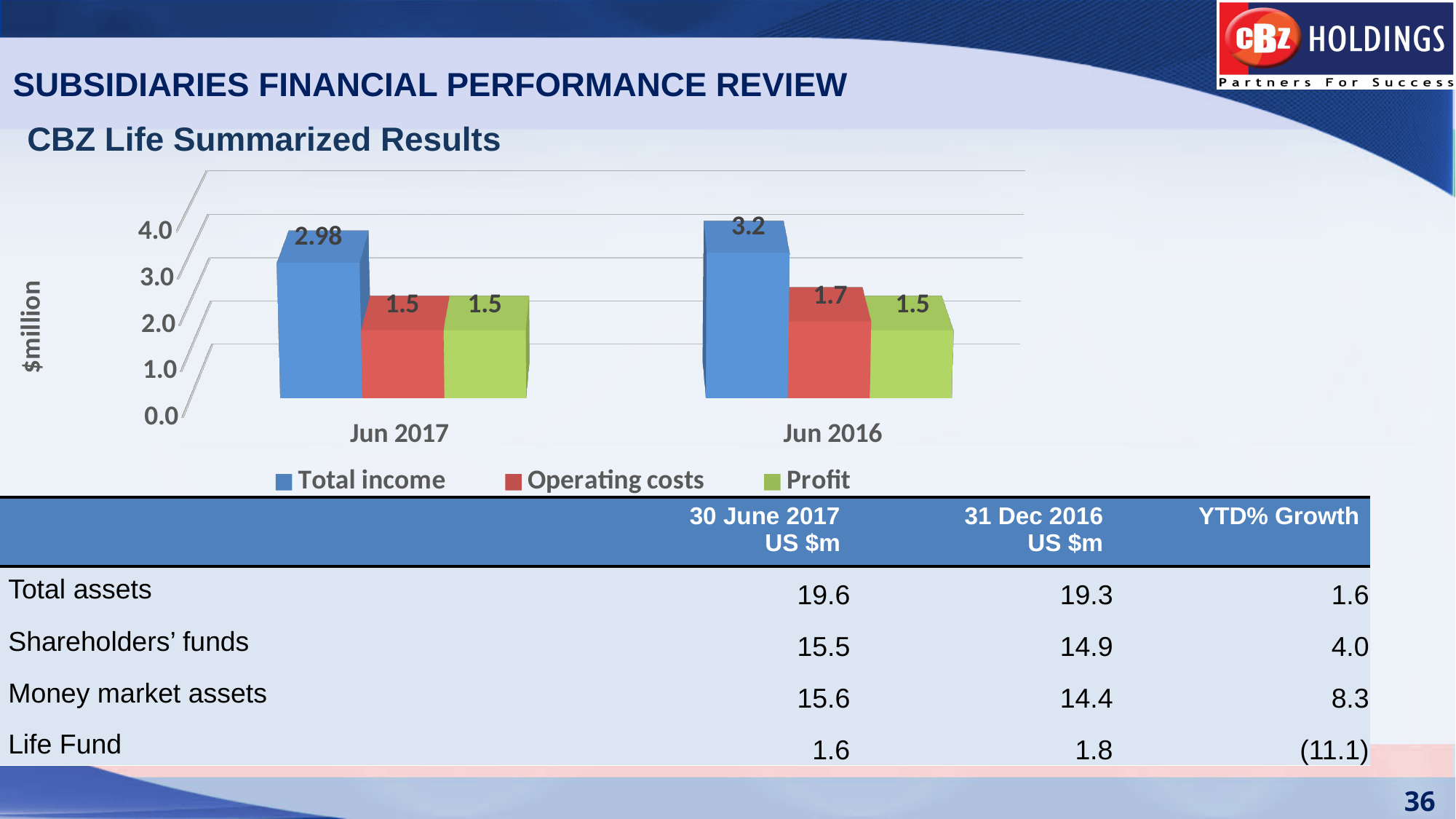
What is the Total income for Jun 2016? 3.2 How many series does the legend list? 3 What is the Operating costs value for Jun 2016? 1.7 What is the label on the vertical axis? $million What is the difference in Total income between Jun 2016 and Jun 2017? 0.22 How many periods are shown on the x axis? 2 What is the Profit for Jun 2017? 1.5 What is the Total income for Jun 2017? 2.98 Which period has the higher Total income? Jun 2016 What is the difference in Operating costs between Jun 2016 and Jun 2017? 0.2 What kind of chart is shown? Bar chart Is Operating costs larger in Jun 2017 or Jun 2016? Jun 2016